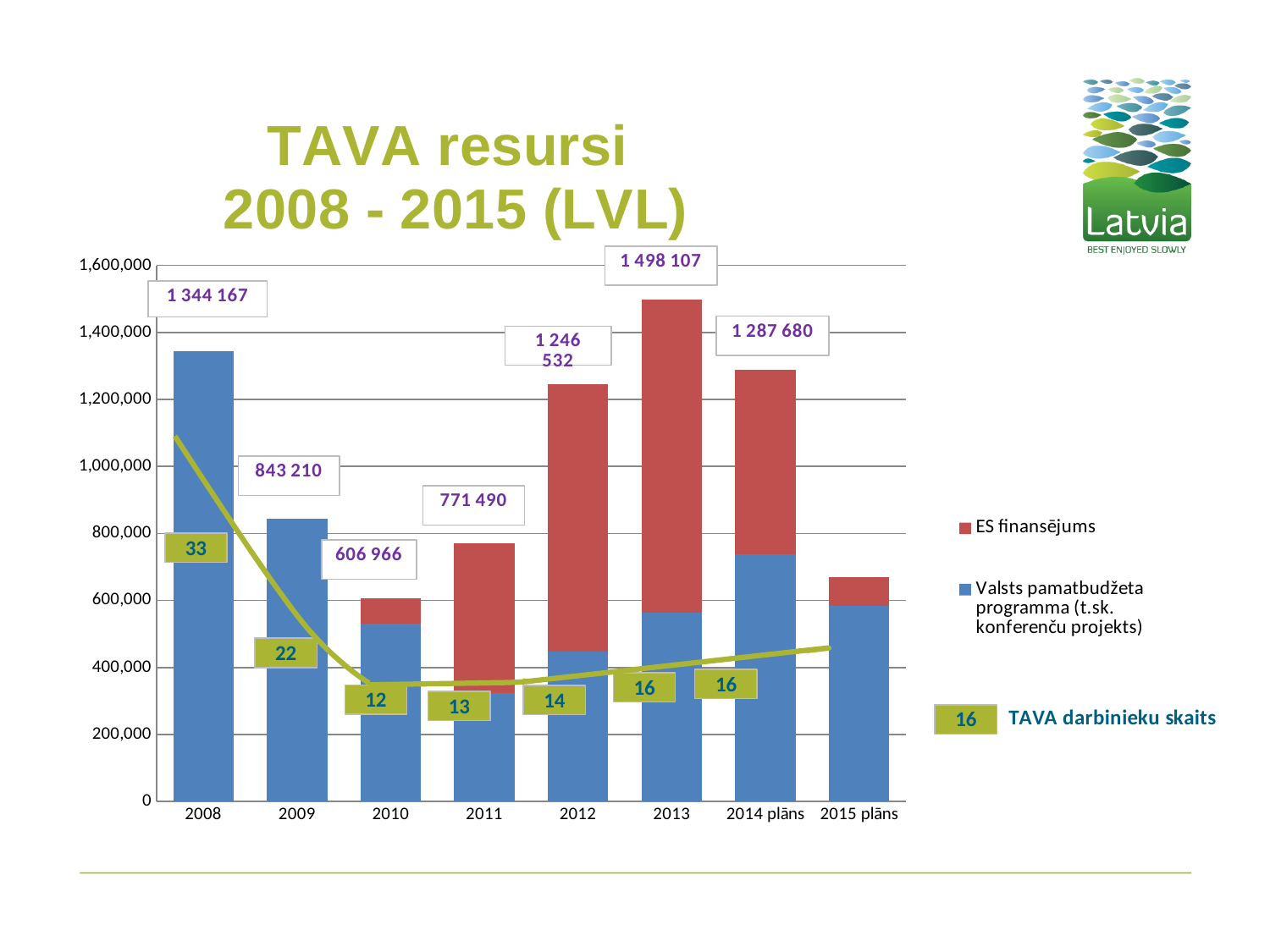
Does the employee count line rise or fall from 2008 to 2010? fall What is the TAVA darbinieku skaits (employee count) shown for 2010? 12 What is the difference between the total resources for 2013 and 2012? 251 575 Which year has the lowest total resources? 2010 What is the total resource value labelled for 2010? 606 966 What is the TAVA darbinieku skaits (employee count) shown for 2008? 33 Which year has the highest total resources? 2013 Which year has larger total resources, 2009 or 2011? 2009 Is the total value for 2015 plāns greater or less than 800,000? less How many series does the legend list for the stacked bars? 2 What is the total resource value labelled for 2013? 1 498 107 How many years (categories) are shown on the x axis? 8